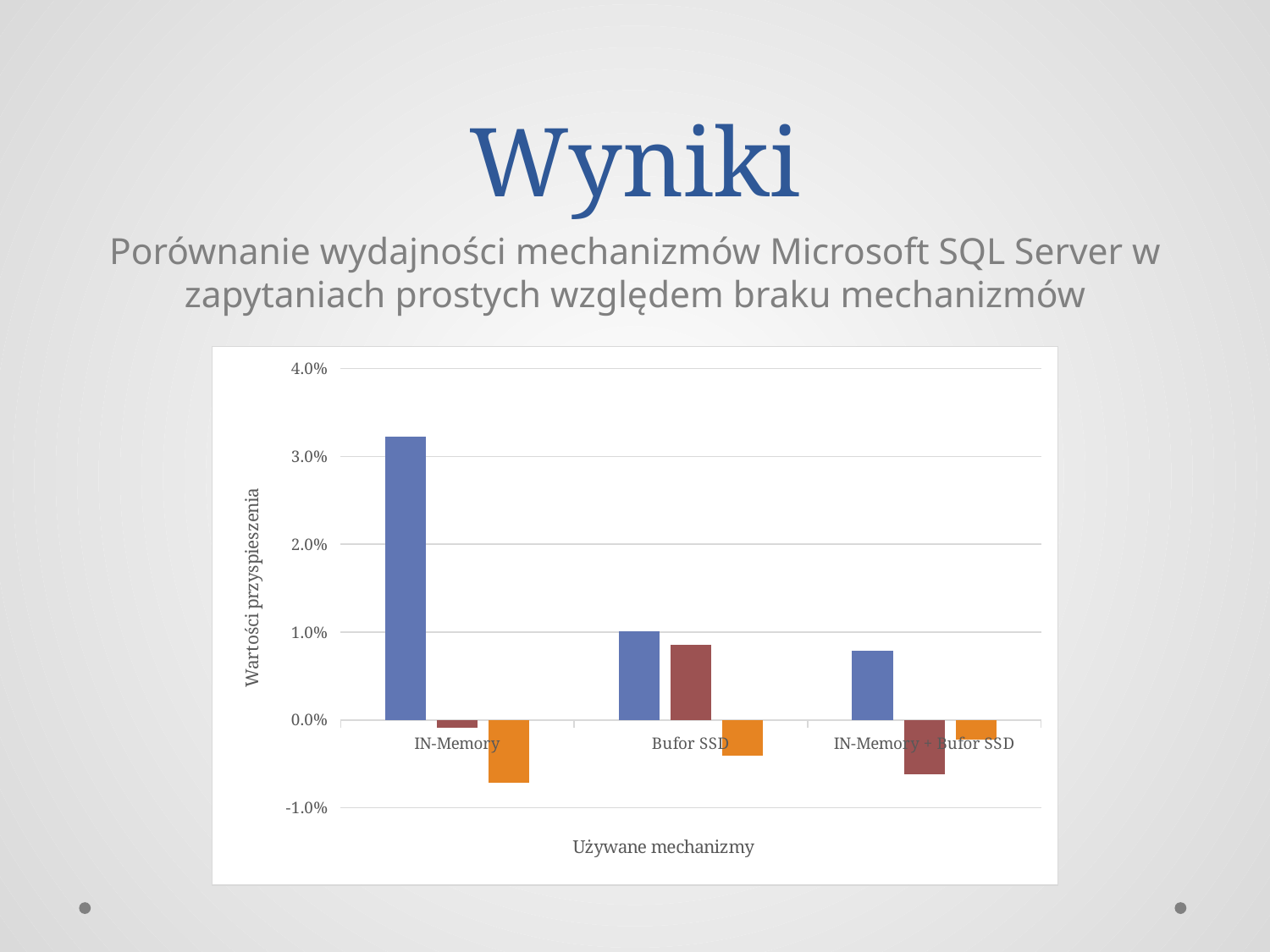
How many bars are plotted for each category in the chart? 3 How many categories are shown on the x axis of the chart? 3 Which category has the lowest orange bar in the chart? IN-Memory Which category has the tallest blue bar in the chart? IN-Memory What kind of chart is shown on the slide? bar chart What is the title of the vertical axis of the chart? Wartości przyspieszenia What is the title of the horizontal axis of the chart? Używane mechanizmy Which is larger: the blue bar for IN-Memory or the blue bar for Bufor SSD? IN-Memory Is the value of the red bar for Bufor SSD greater or less than 0.0%? greater Is the value of the blue bar for IN-Memory + Bufor SSD greater or less than 1.0%? less Is the value of the orange bar for IN-Memory greater or less than 0.0%? less